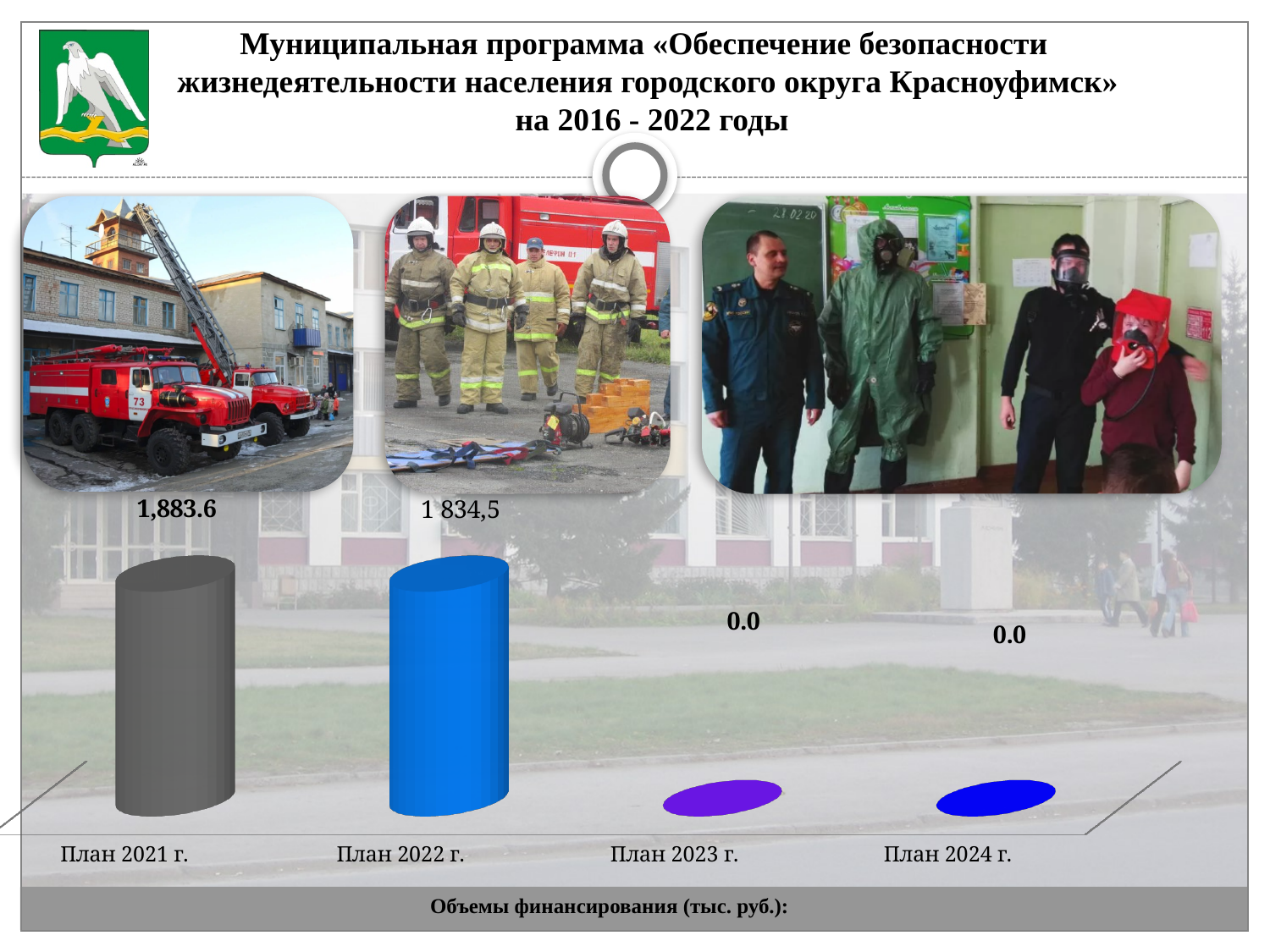
What is the difference between the values for План 2021 г. and План 2022 г.? 49.1 Which is larger, the value for План 2021 г. or План 2022 г.? План 2021 г. What is the value for План 2024 г.? 0.0 How many categories are shown in the chart? 4 What is the value for План 2021 г.? 1,883.6 What is the value for План 2023 г.? 0.0 Do the values rise or fall from План 2021 г. to План 2024 г.? fall Which category has the highest value? План 2021 г. What colour is the bar for План 2022 г.? blue What is the title of the chart? Объемы финансирования (тыс. руб.): What kind of chart is shown on the slide? bar chart What is the value for План 2022 г.? 1 834,5